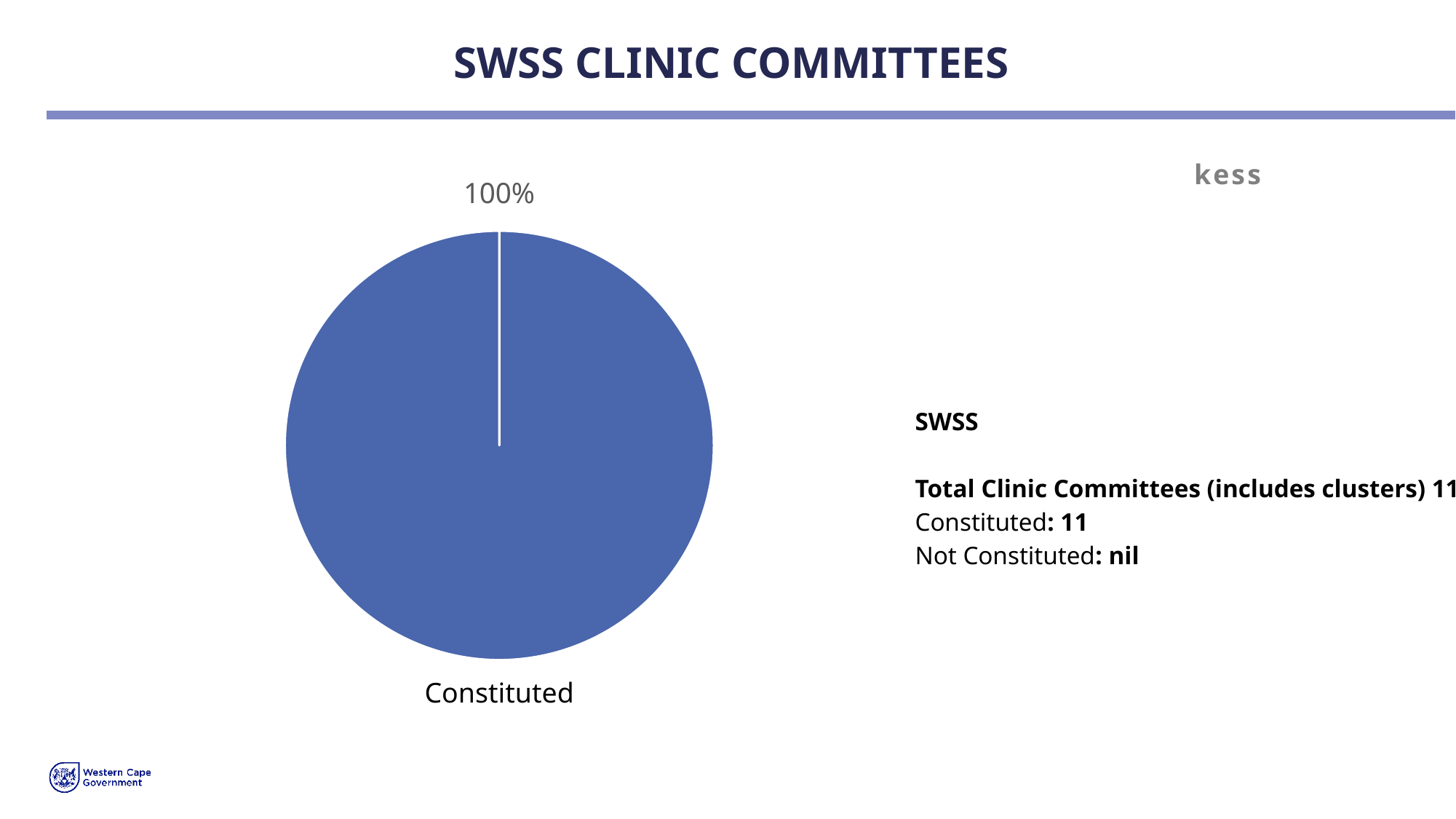
What colour is the Constituted slice of the pie chart? blue What is the label of the only slice in the pie chart? Constituted How many slices does the pie chart have? 1 What share of the pie does the Constituted slice represent? 100% Is the share for Constituted greater or less than 50%? greater What kind of chart is shown on the slide? pie chart